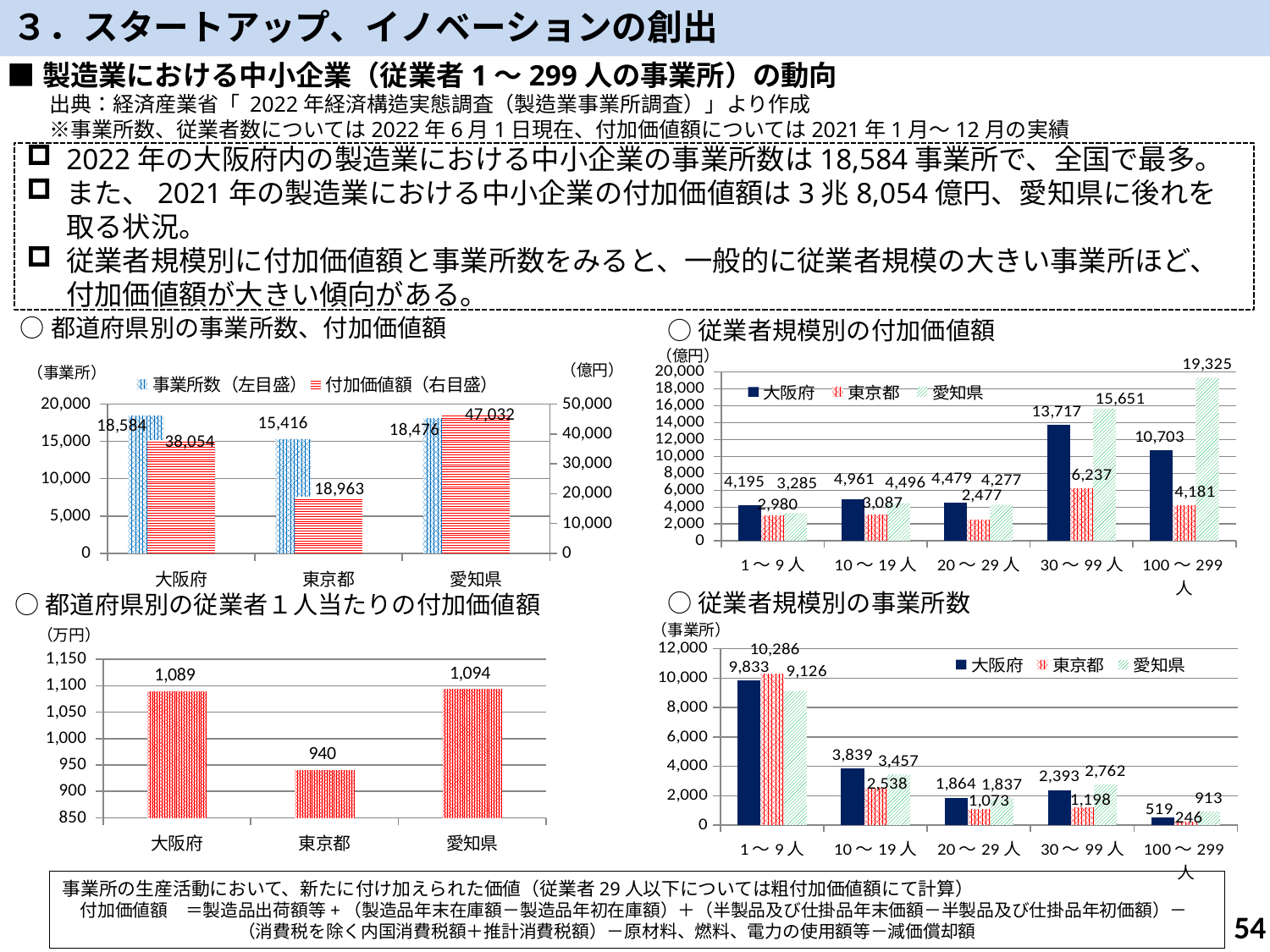
In the chart titled 従業者規模別の事業所数, what is the difference between 大阪府 and 東京都 in the 100～299人 category? 273 In the chart titled 都道府県別の事業所数、付加価値額, what is the 事業所数 value for 大阪府? 18,584 In the chart titled 都道府県別の従業者1人当たりの付加価値額, what is the value for 東京都? 940 In the chart titled 従業者規模別の付加価値額, how many series does the legend list? 3 In the chart titled 従業者規模別の付加価値額, which is larger for the 30～99人 category: 大阪府 or 愛知県? 愛知県 In the chart titled 都道府県別の事業所数、付加価値額, which prefecture has the highest 付加価値額? 愛知県 In the chart titled 都道府県別の従業者1人当たりの付加価値額, which prefecture has the lowest value? 東京都 In the chart titled 従業者規模別の付加価値額, what is the value for 愛知県 in the 100～299人 category? 19,325 In the chart titled 従業者規模別の事業所数, how many employee-size categories are shown on the x axis? 5 What kind of chart is the one titled 都道府県別の従業者1人当たりの付加価値額? Bar chart In the chart titled 都道府県別の事業所数、付加価値額, what is the difference between the 付加価値額 of 愛知県 and 大阪府? 8,978 In the chart titled 従業者規模別の事業所数, what is the value for 東京都 in the 1～9人 category? 10,286